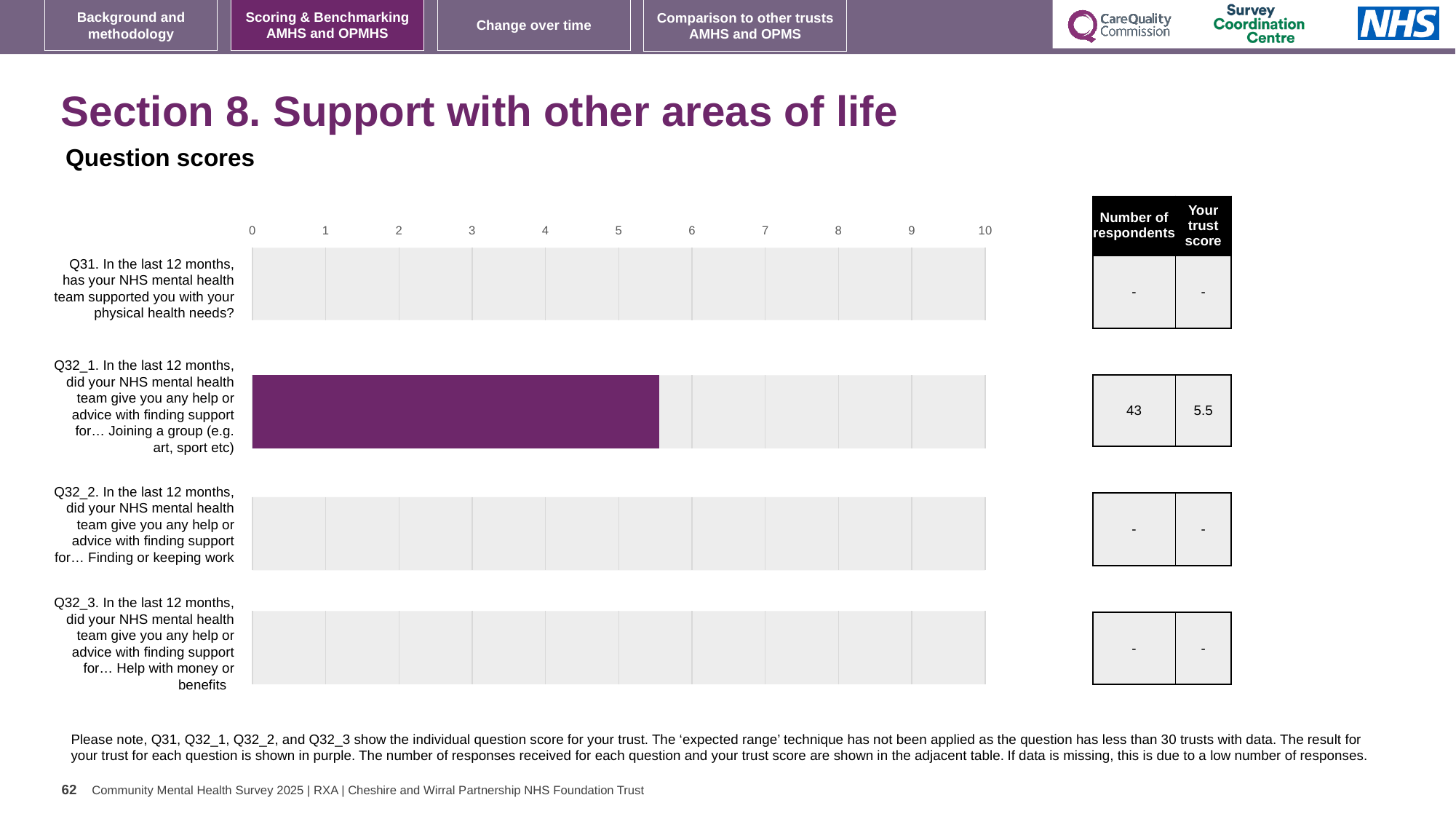
How many questions (categories) are plotted on the chart? 4 What colour is the bar for Q32_1? purple What kind of chart is used to show the question scores? bar chart What is the maximum value shown on the chart's axis? 10 Which question is the only one with a plotted bar on the chart? Q32_1 What is the trust score for Q32_1 (help or advice with finding support for joining a group)? 5.5 How many respondents are listed for Q32_1 in the adjacent table? 43 How many of the four questions show missing data ("-") in the table? 3 Is the value for Q32_1 greater or less than 5? greater What is shown as the trust score for Q31 in the table? - Is the value for Q32_1 greater or less than 6? less